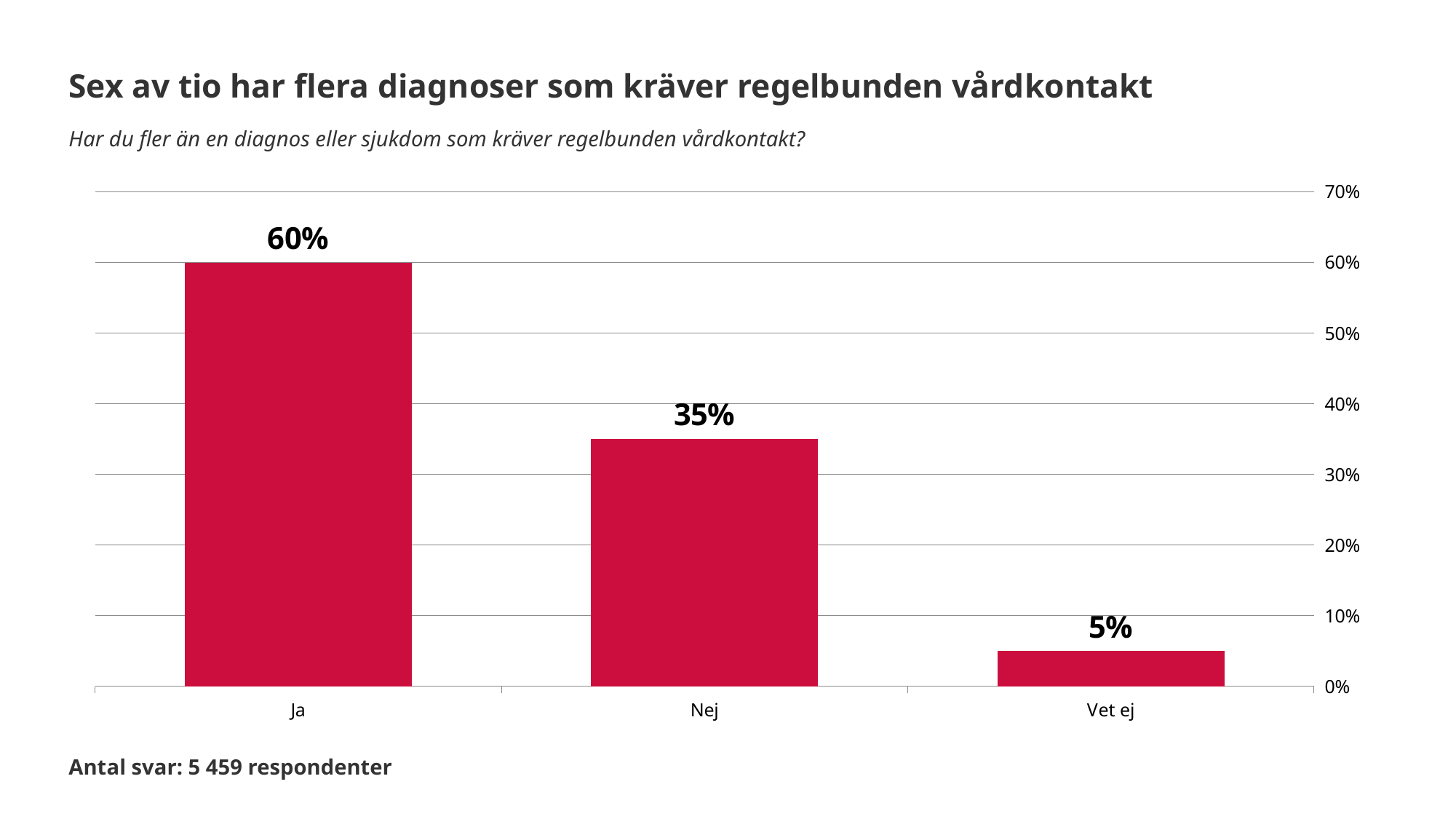
What is the difference between the values for "Ja" and "Nej"? 25% How many respondents answered the survey, according to the note below the chart? 5 459 respondenter What is the value for "Nej"? 35% Which category has the lowest value? Vet ej What is the value for "Ja"? 60% What kind of chart is shown on the slide? bar chart What is the difference between the values for "Nej" and "Vet ej"? 30% What is the value for "Vet ej"? 5% Is the value for "Nej" greater or less than 40%? less Which category has the highest value? Ja How many categories are shown on the x axis? 3 Which is larger, the value for "Nej" or the value for "Vet ej"? Nej